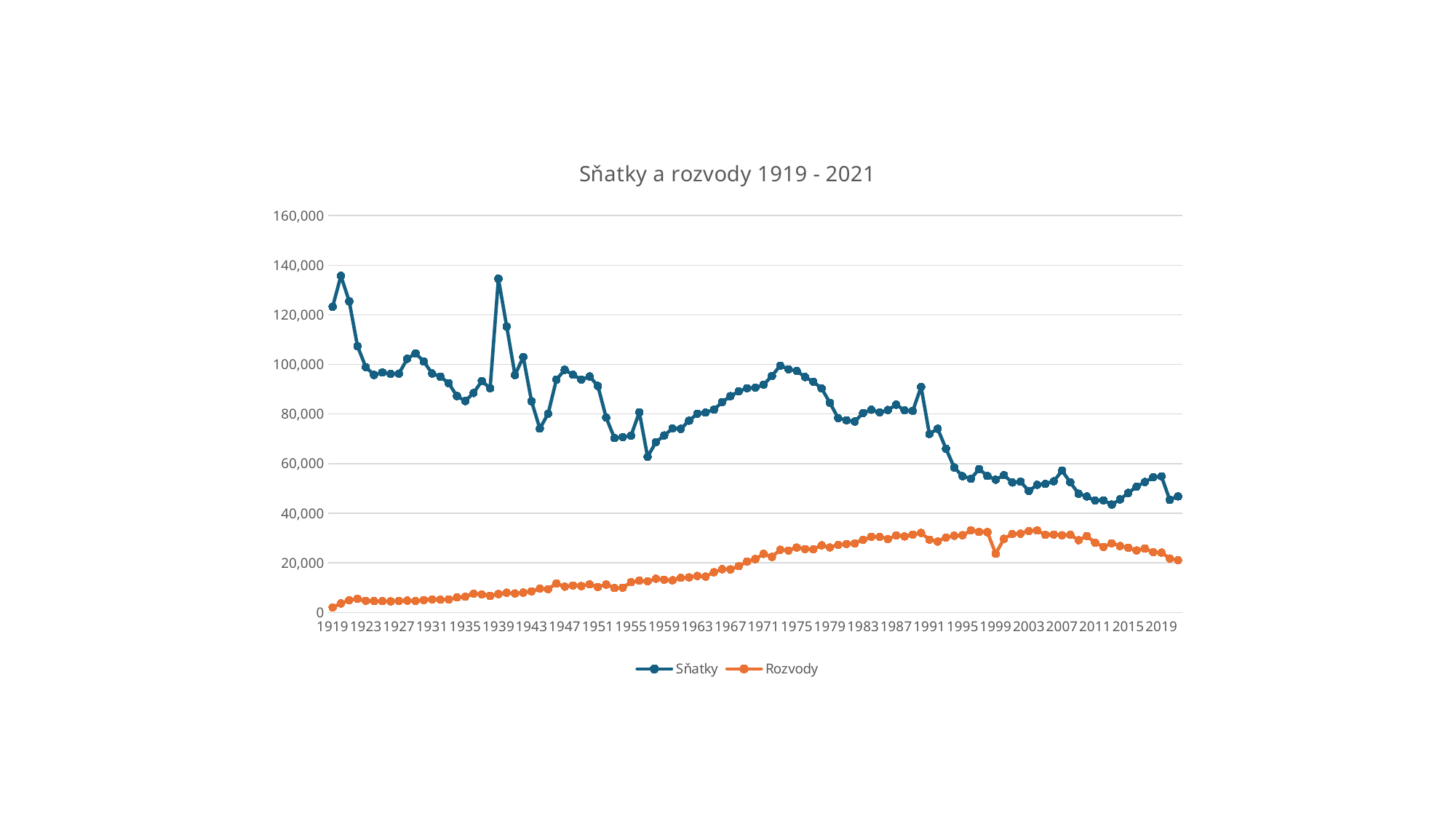
In which year is the value for Rozvody lowest? 1919 Is the value for Rozvody in 2021 greater or less than 40,000? less What are the two series named in the legend? Sňatky and Rozvody What is the title of the chart? Sňatky a rozvody 1919 - 2021 Overall, do the values for Sňatky rise or fall from 1919 to 2021? fall Is the value for Sňatky in 1939 greater or less than 120,000? greater How many series does the legend list? 2 Do the values for Rozvody rise or fall from 1919 to 1991? rise In 1971, which series has the larger value, Sňatky or Rozvody? Sňatky What kind of chart is shown on the slide? line chart Is the value for Rozvody in 2003 greater or less than 20,000? greater